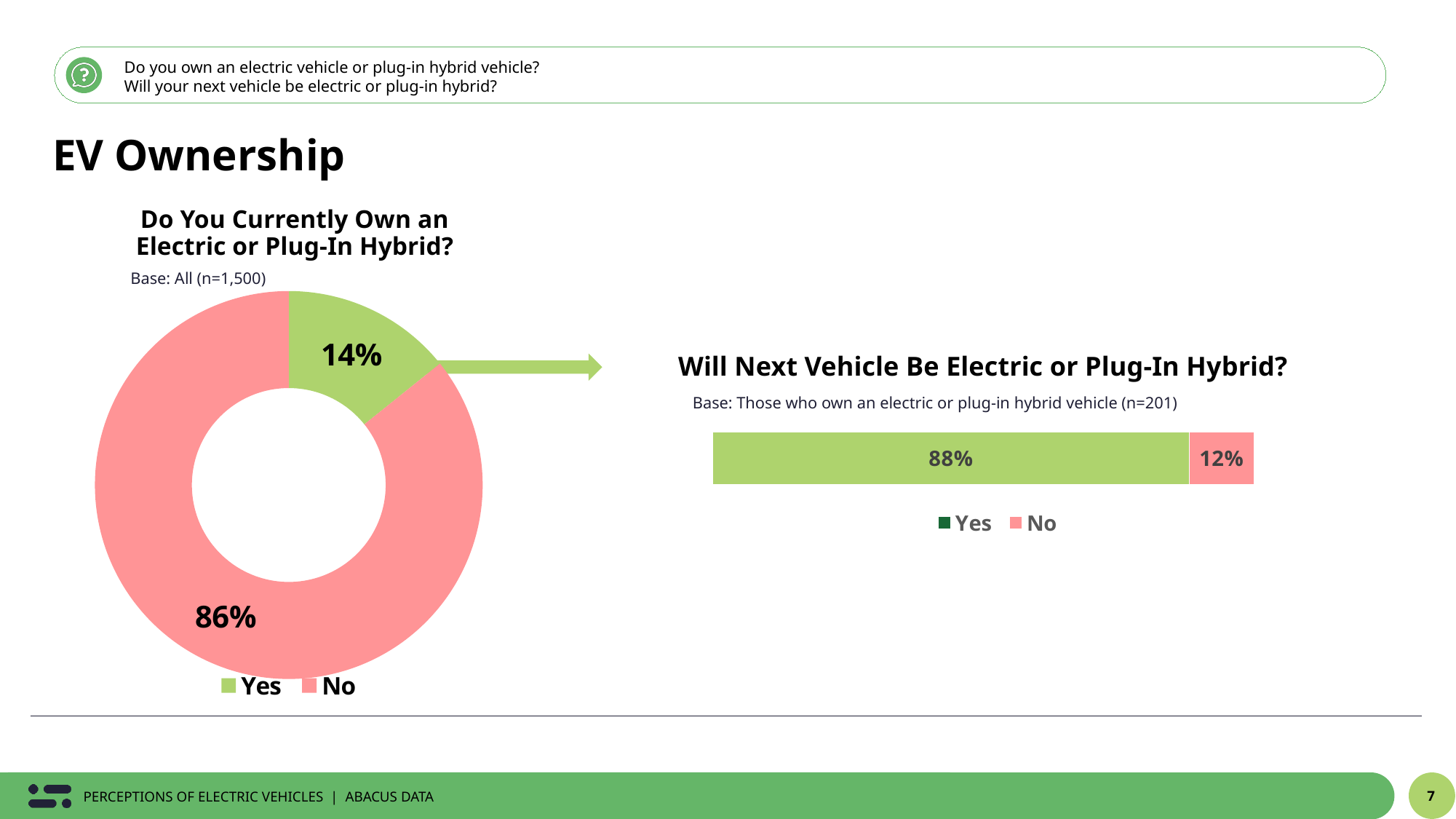
What type of chart is the 'Will Next Vehicle Be Electric or Plug-In Hybrid?' chart? Stacked bar chart In the 'Do You Currently Own an Electric or Plug-In Hybrid?' chart, what is the difference between the No and Yes percentages? 72% What type of chart is the 'Do You Currently Own an Electric or Plug-In Hybrid?' chart? Donut chart In the 'Do You Currently Own an Electric or Plug-In Hybrid?' chart, what percentage answered Yes? 14% In the 'Will Next Vehicle Be Electric or Plug-In Hybrid?' chart, what percentage answered No? 12% How many series does the legend of the 'Will Next Vehicle Be Electric or Plug-In Hybrid?' chart list? 2 In the 'Do You Currently Own an Electric or Plug-In Hybrid?' chart, which response has the larger share? No In the 'Will Next Vehicle Be Electric or Plug-In Hybrid?' chart, which response has the smaller share? No In the 'Do You Currently Own an Electric or Plug-In Hybrid?' chart, what percentage answered No? 86% In the 'Will Next Vehicle Be Electric or Plug-In Hybrid?' chart, what is the difference between the Yes and No percentages? 76% In the 'Will Next Vehicle Be Electric or Plug-In Hybrid?' chart, what percentage answered Yes? 88% What is the base sample size shown for the 'Will Next Vehicle Be Electric or Plug-In Hybrid?' chart? n=201